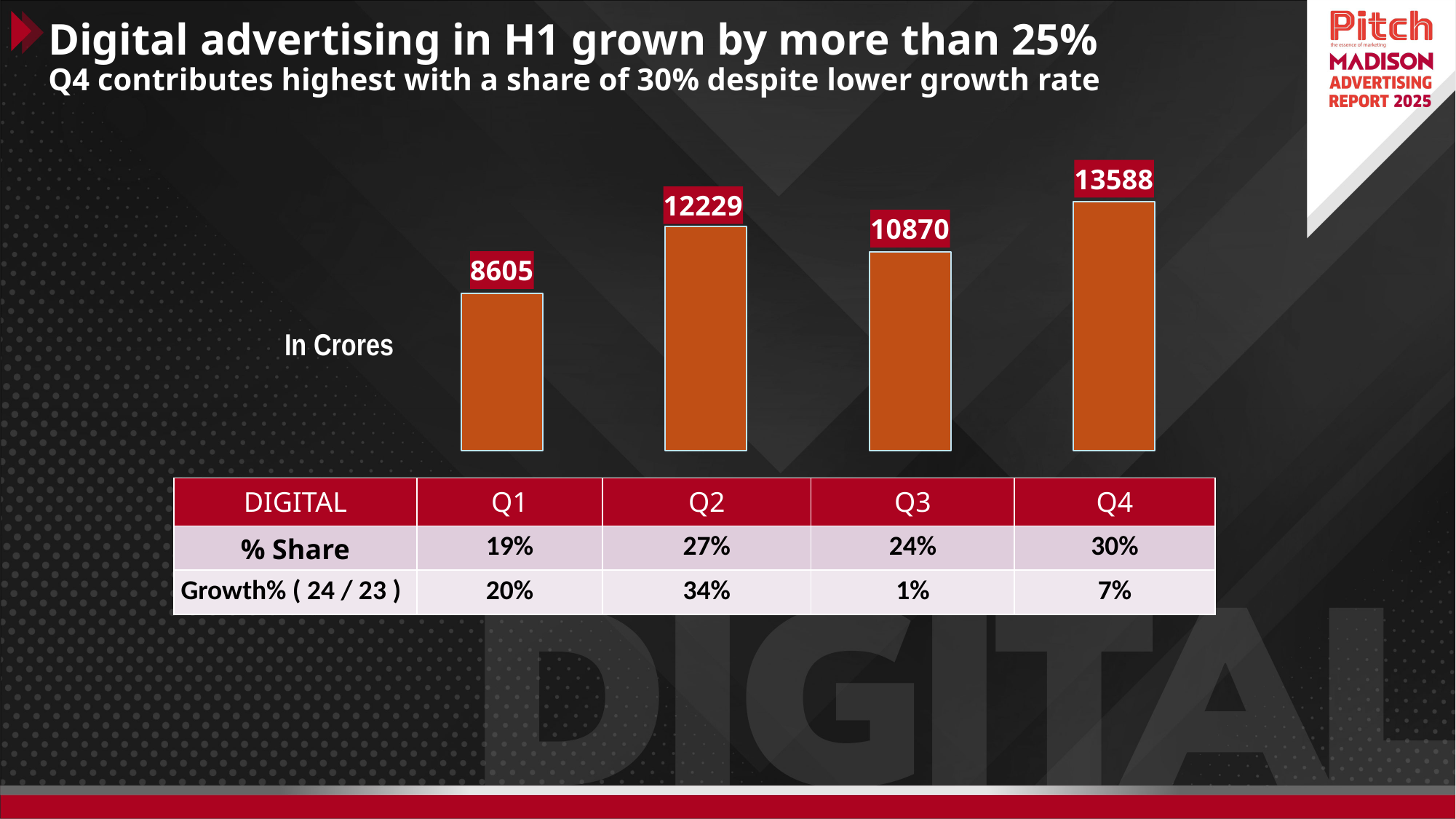
What is the digital advertising value for Q1 in crores? 8605 What kind of chart is shown on the slide? Bar chart What is the digital advertising value for Q2 in crores? 12229 Which is larger, the digital advertising value for Q2 or for Q3? Q2 How many quarters are plotted in the chart? 4 What unit label is shown next to the chart? In Crores Which quarter has the lowest digital advertising value? Q1 Which quarter has the highest digital advertising value? Q4 What is the difference between the Q2 and Q3 digital advertising values? 1359 What is the digital advertising value for Q4 in crores? 13588 What is the difference between the Q4 and Q1 digital advertising values? 4983 What is the digital advertising value for Q3 in crores? 10870